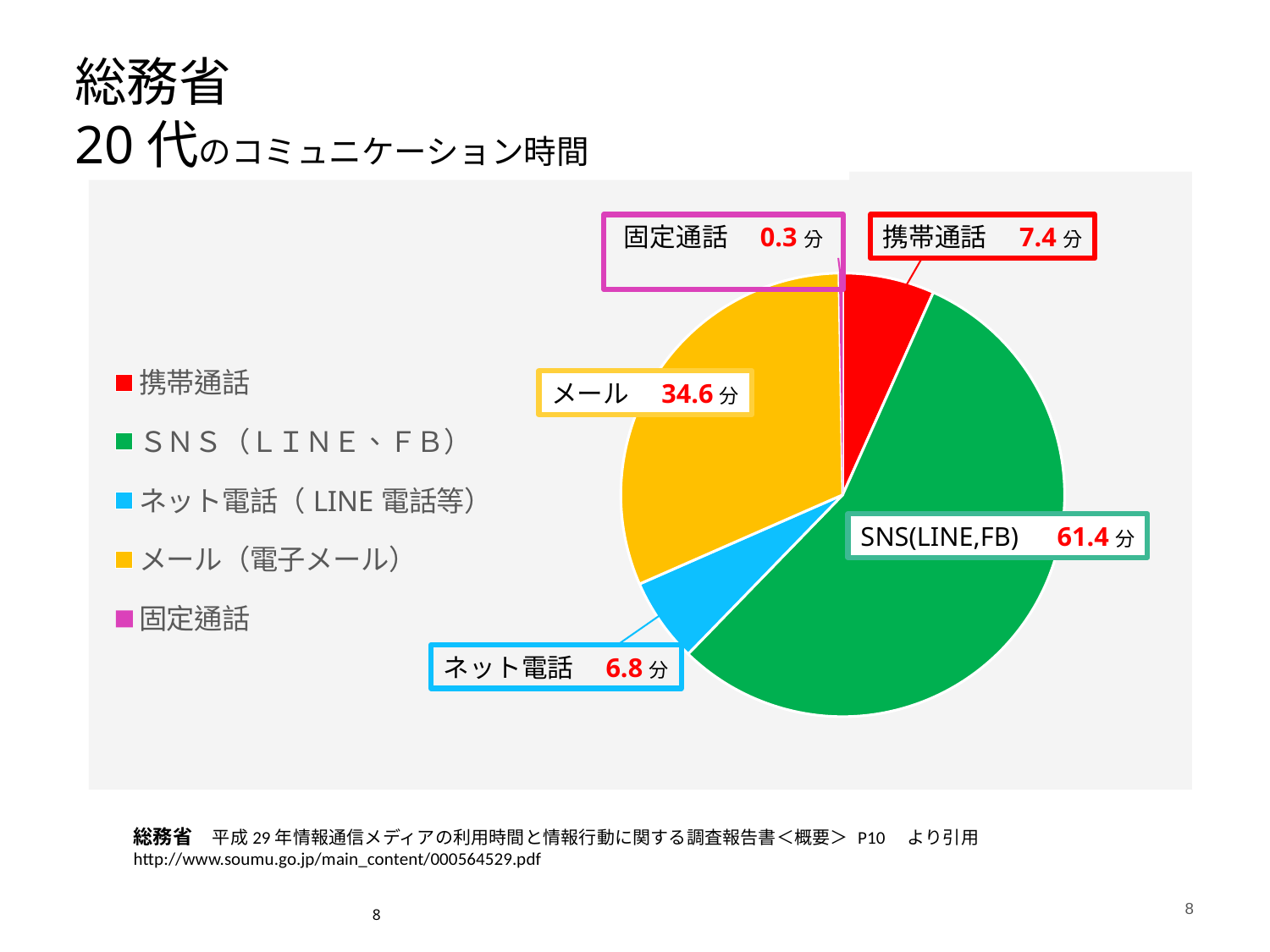
What kind of chart is shown on the slide? pie chart What colour is the slice for メール in the pie chart? yellow What is the value for ネット電話 in the pie chart? 6.8分 What is the value for 固定通話 in the pie chart? 0.3分 What is the value for 携帯通話 in the pie chart? 7.4分 What is the value for メール in the pie chart? 34.6分 Which is larger, the value for 携帯通話 or the value for ネット電話? 携帯通話 What is the value for SNS(LINE,FB) in the pie chart? 61.4分 Which category has the largest slice in the pie chart? SNS(LINE,FB) Which category has the smallest slice in the pie chart? 固定通話 What is the difference between the values for SNS(LINE,FB) and メール? 26.8分 How many categories does the pie chart have? 5